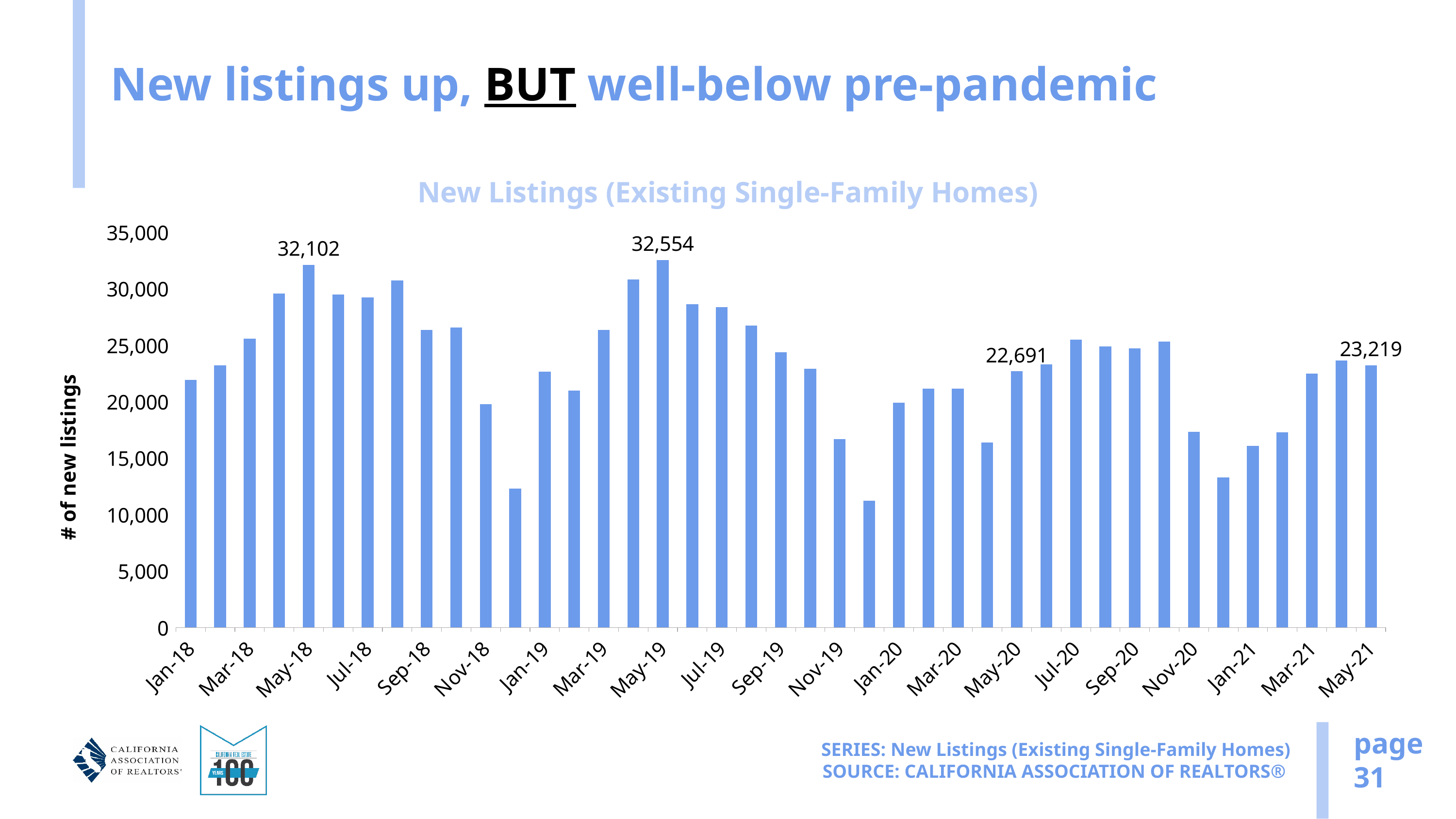
What is the value of new listings for May-20? 22,691 Is the value for Nov-19 greater or less than 20,000? less What is the value of new listings for May-21? 23,219 What type of chart is shown on the slide? bar chart What is the title of the chart? New Listings (Existing Single-Family Homes) What is the value of new listings for May-18? 32,102 Which is larger, the value for May-18 or the value for May-19? May-19 What is the value of new listings for May-19? 32,554 What is the difference between the May-19 value and the May-21 value? 9,335 Which month has the highest number of new listings? May-19 What is the label on the vertical axis of the chart? # of new listings Do the values rise or fall from May-19 to Nov-19? fall